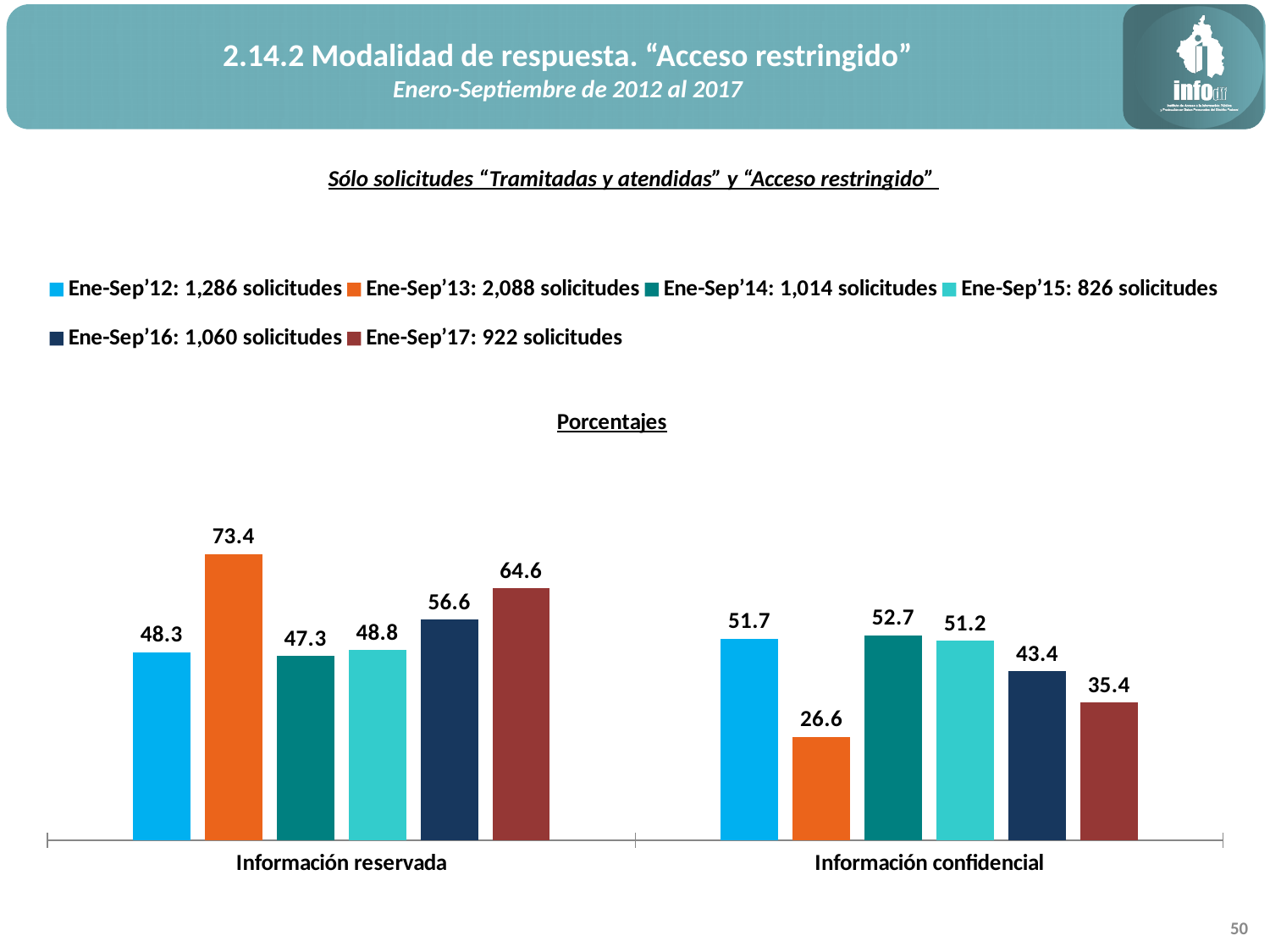
How many series does the legend list? 6 Which series has the highest value in the Información reservada category? Ene-Sep'13 What is the difference between the Ene-Sep'14 and Ene-Sep'16 values in the Información confidencial category? 9.3 What kind of chart is shown on the slide? Bar chart How many categories are shown on the x axis? 2 What is the value for Ene-Sep'17 in the Información confidencial category? 35.4 Which series has the lowest value in the Información confidencial category? Ene-Sep'13 What is the value for Ene-Sep'16 in the Información reservada category? 56.6 According to the legend, how many solicitudes were there in Ene-Sep'13? 2,088 solicitudes What is the difference between the Ene-Sep'13 values for Información reservada and Información confidencial? 46.8 Which is larger: the Ene-Sep'17 value for Información reservada or for Información confidencial? Información reservada What is the value for Ene-Sep'13 in the Información reservada category? 73.4